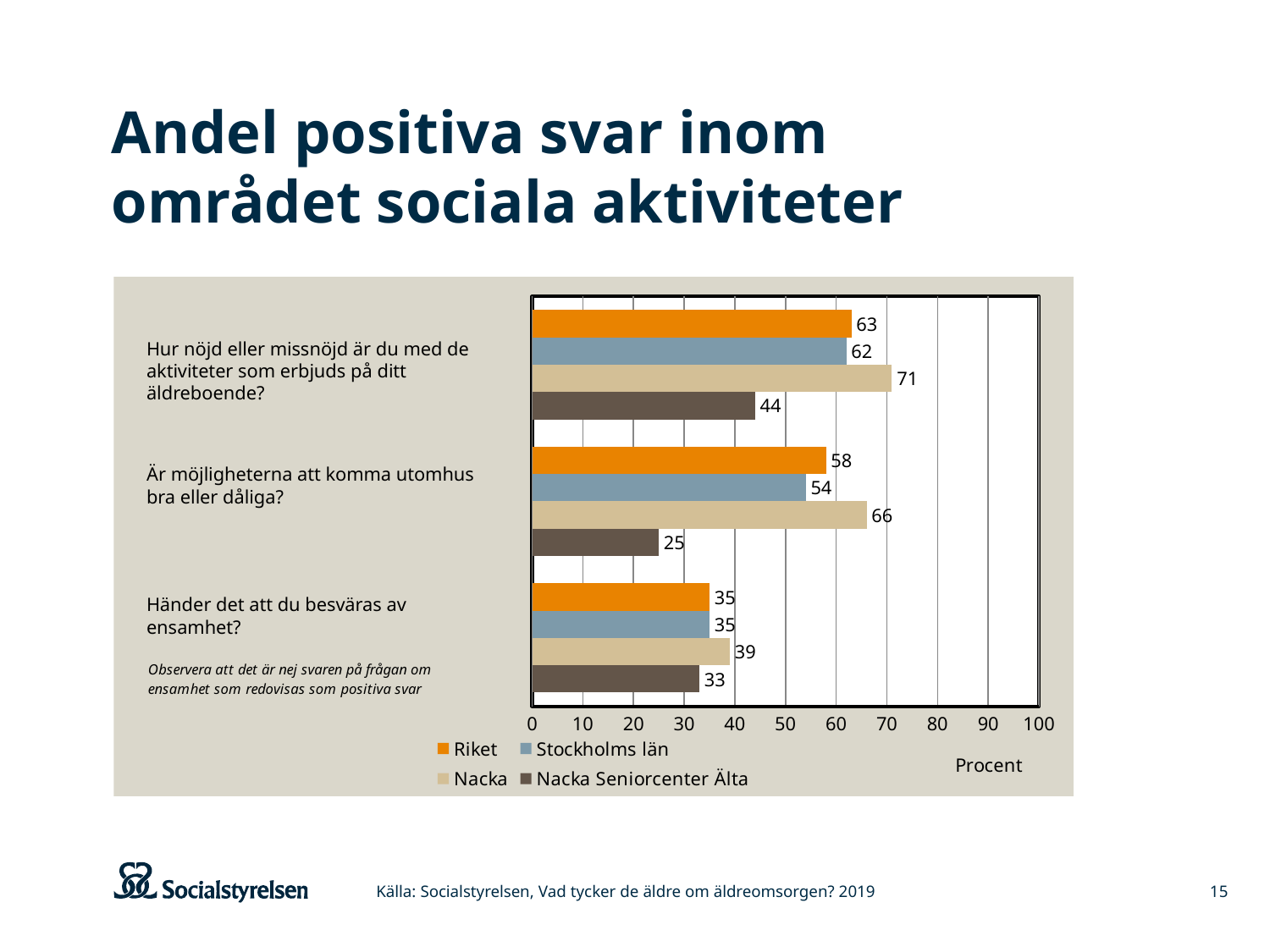
What kind of chart is shown on the slide? bar chart What is the value for Nacka Seniorcenter Älta on the question "Är möjligheterna att komma utomhus bra eller dåliga?"? 25 How many series does the legend list? 4 How many questions (categories) are shown on the chart? 3 What is the label of the horizontal axis? Procent What is the value for Riket on the question "Händer det att du besväras av ensamhet?"? 35 What is the value for Nacka on the question "Hur nöjd eller missnöjd är du med de aktiviteter som erbjuds på ditt äldreboende?"? 71 Which is larger on the question "Är möjligheterna att komma utomhus bra eller dåliga?": Riket or Stockholms län? Riket What is the difference between the Nacka and Nacka Seniorcenter Älta values on the question "Hur nöjd eller missnöjd är du med de aktiviteter som erbjuds på ditt äldreboende?"? 27 Is the value for Nacka Seniorcenter Älta on the question "Händer det att du besväras av ensamhet?" greater or less than 40? less Which series has the highest value on the question "Är möjligheterna att komma utomhus bra eller dåliga?"? Nacka Which series has the lowest value on the question "Hur nöjd eller missnöjd är du med de aktiviteter som erbjuds på ditt äldreboende?"? Nacka Seniorcenter Älta